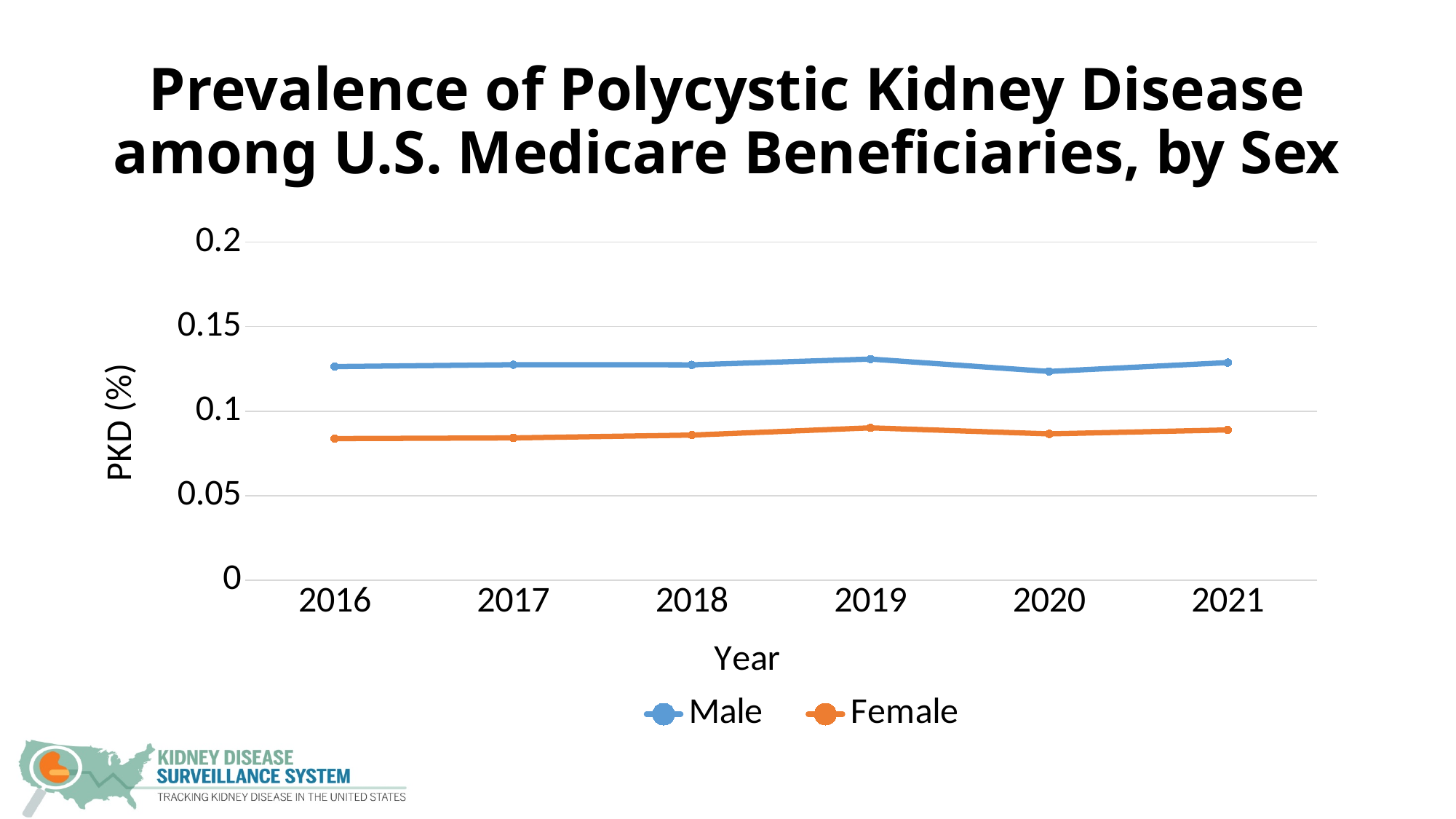
What kind of chart is shown on the slide? Line chart Is the value for Female in 2018 greater or less than 0.1? less Does the Female series rise or fall from 2016 to 2019? Rise Does the Male series rise or fall from 2019 to 2020? Fall What is the label of the y axis? PKD (%) Is the value for Male in 2016 greater or less than 0.1? greater How many series does the legend list? 2 Is the value for Male in 2019 greater or less than 0.15? less In which year is the Male series at its lowest? 2020 How many years are plotted along the x axis? 6 Which series has the larger value in 2020, Male or Female? Male